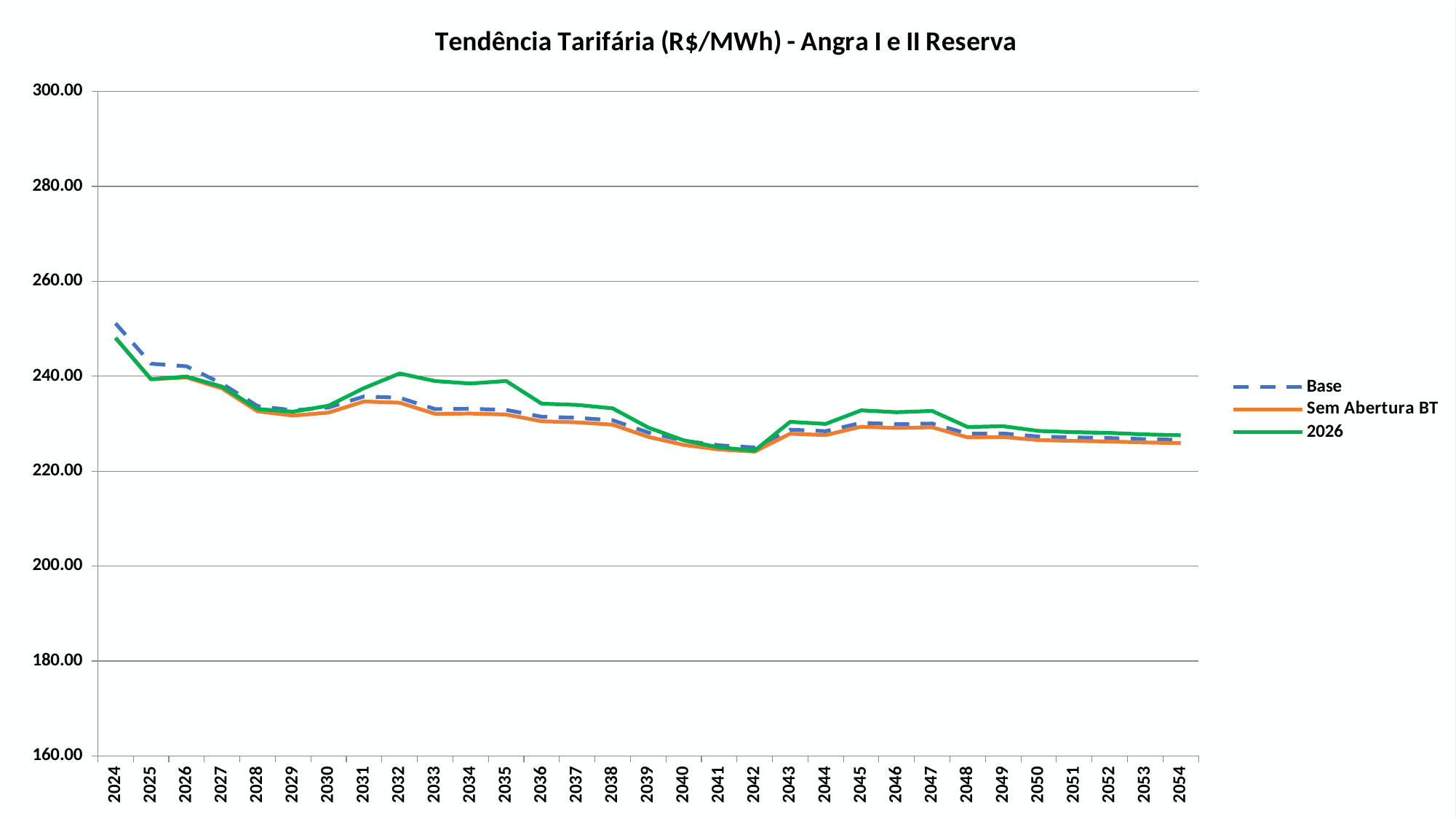
In which year does the Base series reach its highest value? 2024 What kind of chart is shown on the slide? Line chart How many series does the legend list? 3 In 2032, which series has the higher value: 2026 or Sem Abertura BT? 2026 Is the value for Sem Abertura BT in 2054 greater or less than 220.00? greater Which series is drawn with a dashed line? Base In which year does the 2026 series reach its highest value? 2024 In 2024, which series has the higher value: Base or 2026? Base Overall, do the values of the Base series rise or fall from 2024 to 2054? Fall Is the value for Base in 2024 greater or less than 240.00? greater How many years are plotted along the x axis? 31 What is the title of the chart? Tendência Tarifária (R$/MWh) - Angra I e II Reserva